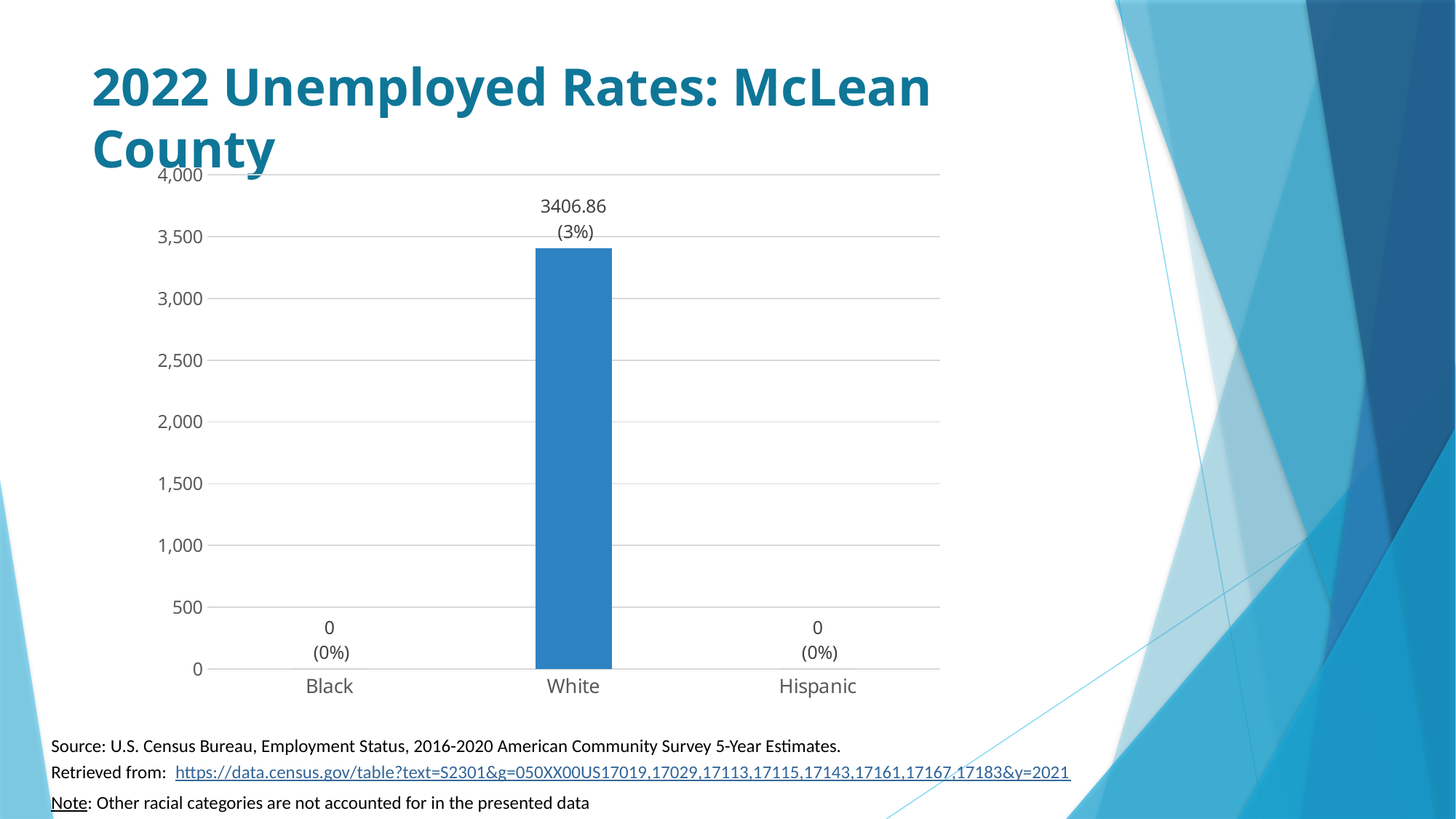
What is the highest value labelled on the y axis? 4,000 What is the title of the slide? 2022 Unemployed Rates: McLean County What is the value shown for Black? 0 Which is larger, the value for White or the value for Hispanic? White What is the value shown for White? 3406.86 What percentage is shown in the data label for White? 3% What kind of chart is shown on the slide? bar chart Is the value for White greater or less than 3,000? greater Which category has the highest value? White What is the difference between the values for White and Black? 3406.86 What is the value shown for Hispanic? 0 How many categories are shown on the x axis? 3